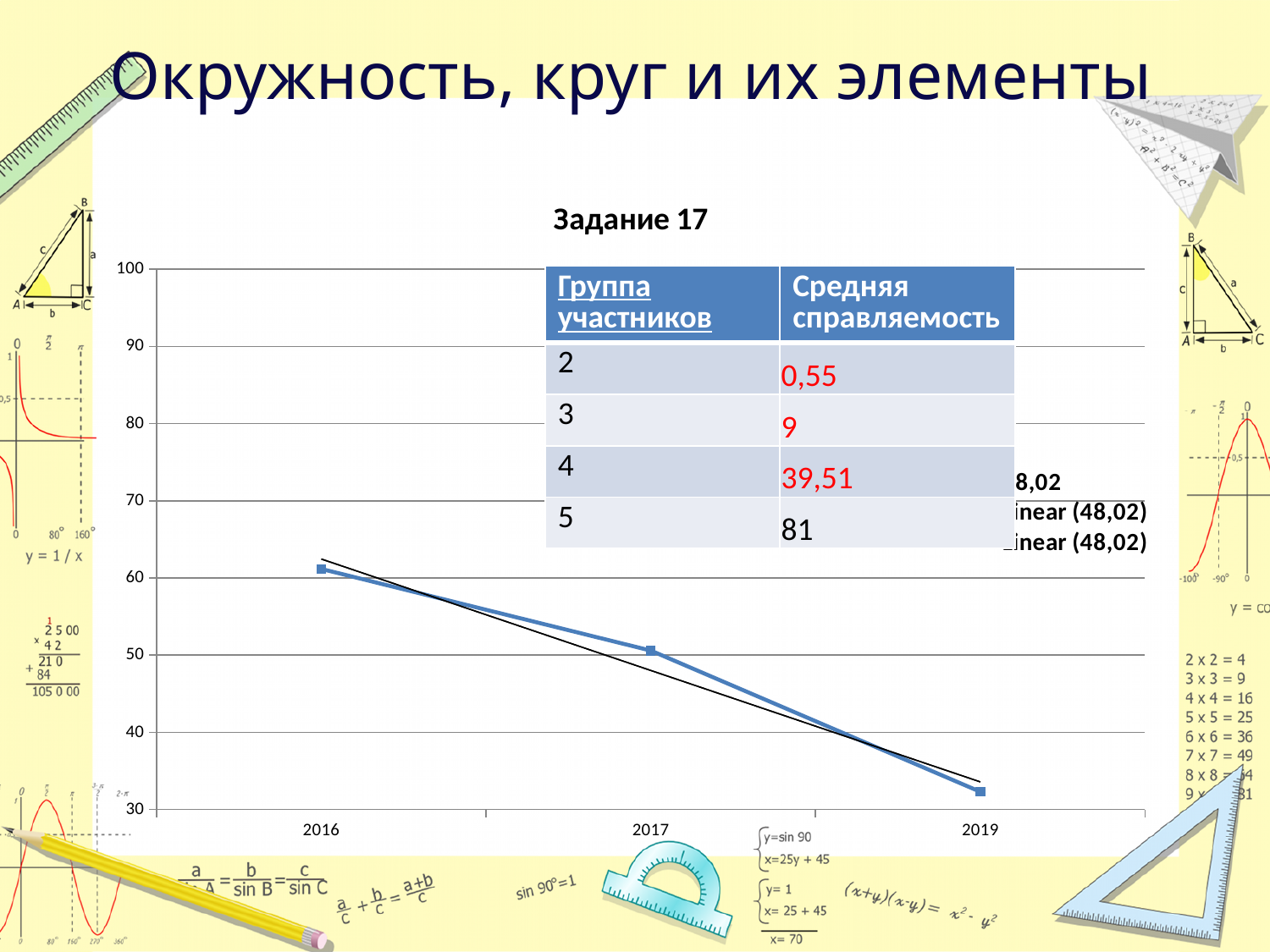
Which year has the highest value on the chart? 2016 What are the lowest and highest values shown on the vertical axis of the chart? 30 and 100 Which year has the lowest value on the chart? 2019 What kind of chart is shown on the slide? line chart What is the title of the chart? Задание 17 Is the value for 2019 greater or less than 40? less Which is larger, the value for 2016 or the value for 2019? 2016 Is the value for 2017 greater or less than 60? less Which is larger, the value for 2017 or the value for 2019? 2017 How many data points are plotted on the line in the chart? 3 Do the values on the chart rise or fall from 2016 to 2019? fall Is the value for 2016 greater or less than 50? greater